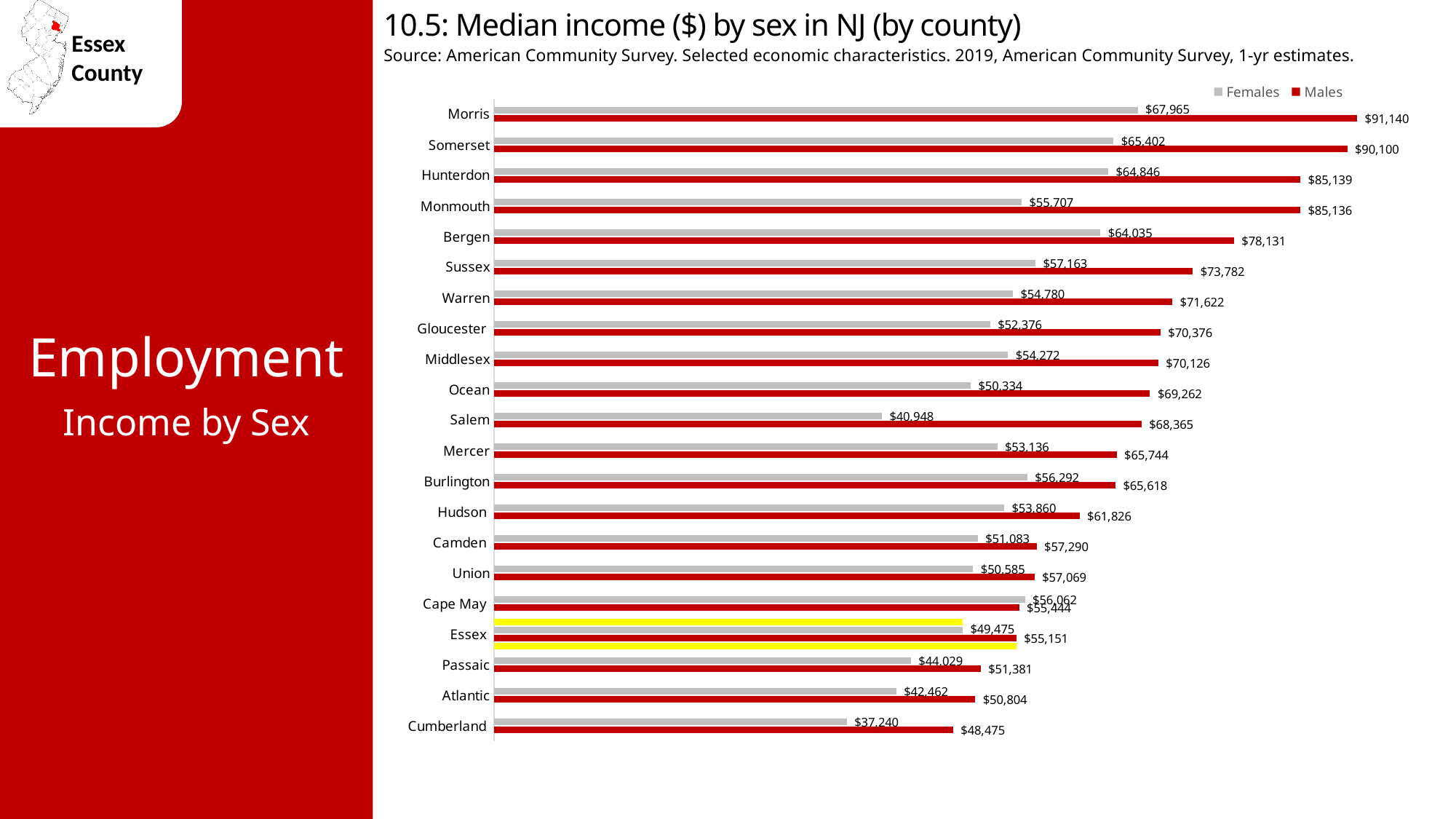
What is the difference between male and female median income in Morris County? $23,175 Which county has a higher median income for males, Hudson or Camden? Hudson What is the difference between male and female median income in Essex County? $5,676 In Cape May County, which is higher: the median income for females or for males? Females What is the median income for males in Essex County? $55,151 What is the median income for females in Salem County? $40,948 Which county has the highest median income for males? Morris What type of chart is shown on the slide? Bar chart How many counties are shown in the chart? 21 Which county has the lowest median income for females? Cumberland What is the median income for females in Morris County? $67,965 How many series does the legend list? 2